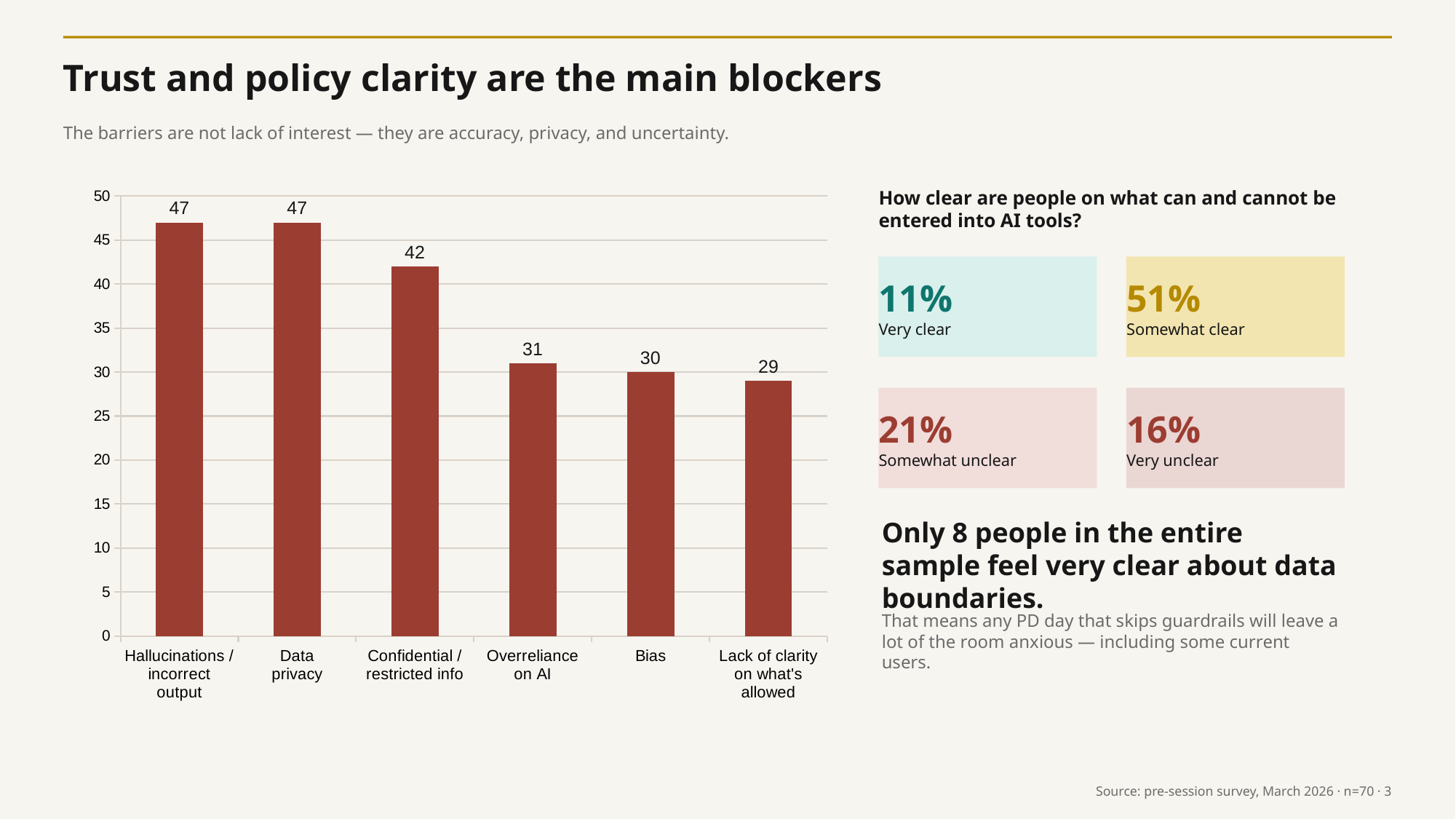
What is the highest value shown on the y axis of the bar chart? 50 Is the value for Bias greater or less than 35? less What kind of chart is shown on the slide? bar chart What is the value for Bias? 30 What is the value for Confidential / restricted info? 42 Which is larger, the value for Hallucinations / incorrect output or the value for Overreliance on AI? Hallucinations / incorrect output What is the difference between the values for Data privacy and Bias? 17 What is the value for Overreliance on AI? 31 Do the values rise or fall from left to right along the x axis? fall Which category has the lowest value? Lack of clarity on what's allowed What is the difference between the values for Confidential / restricted info and Lack of clarity on what's allowed? 13 How many categories are shown in the bar chart? 6